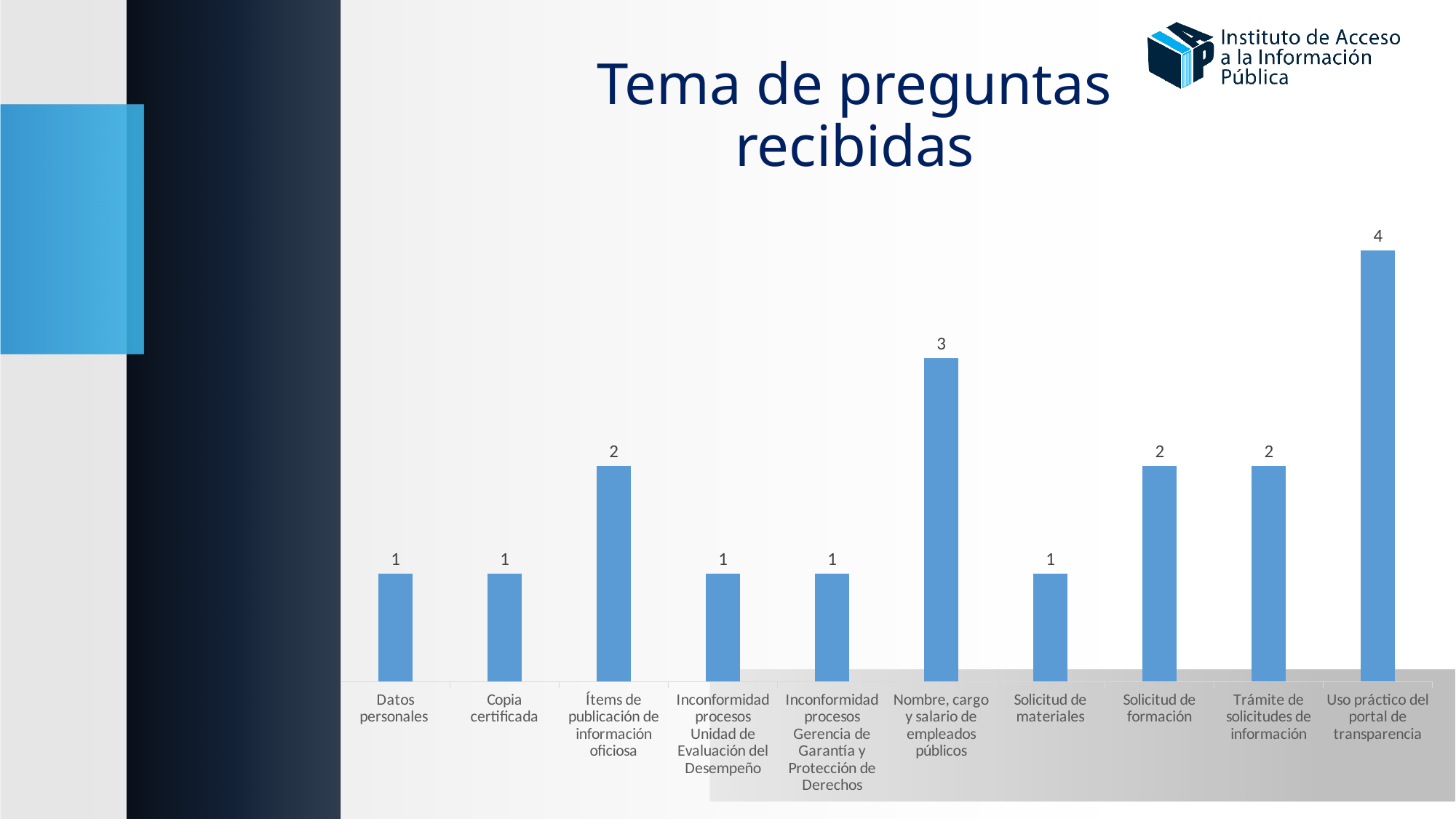
How many categories have a value of 1? 5 What is the value for Uso práctico del portal de transparencia? 4 Which is larger, the value for Trámite de solicitudes de información or the value for Solicitud de materiales? Trámite de solicitudes de información What is the value for Solicitud de formación? 2 What is the difference between the values for Uso práctico del portal de transparencia and Nombre, cargo y salario de empleados públicos? 1 What is the value for Nombre, cargo y salario de empleados públicos? 3 What kind of chart is shown on the slide? Bar chart What is the title of the slide? Tema de preguntas recibidas What is the difference between the values for Ítems de publicación de información oficiosa and Copia certificada? 1 Which category has the highest value? Uso práctico del portal de transparencia What is the value for Datos personales? 1 How many categories are shown in the chart? 10